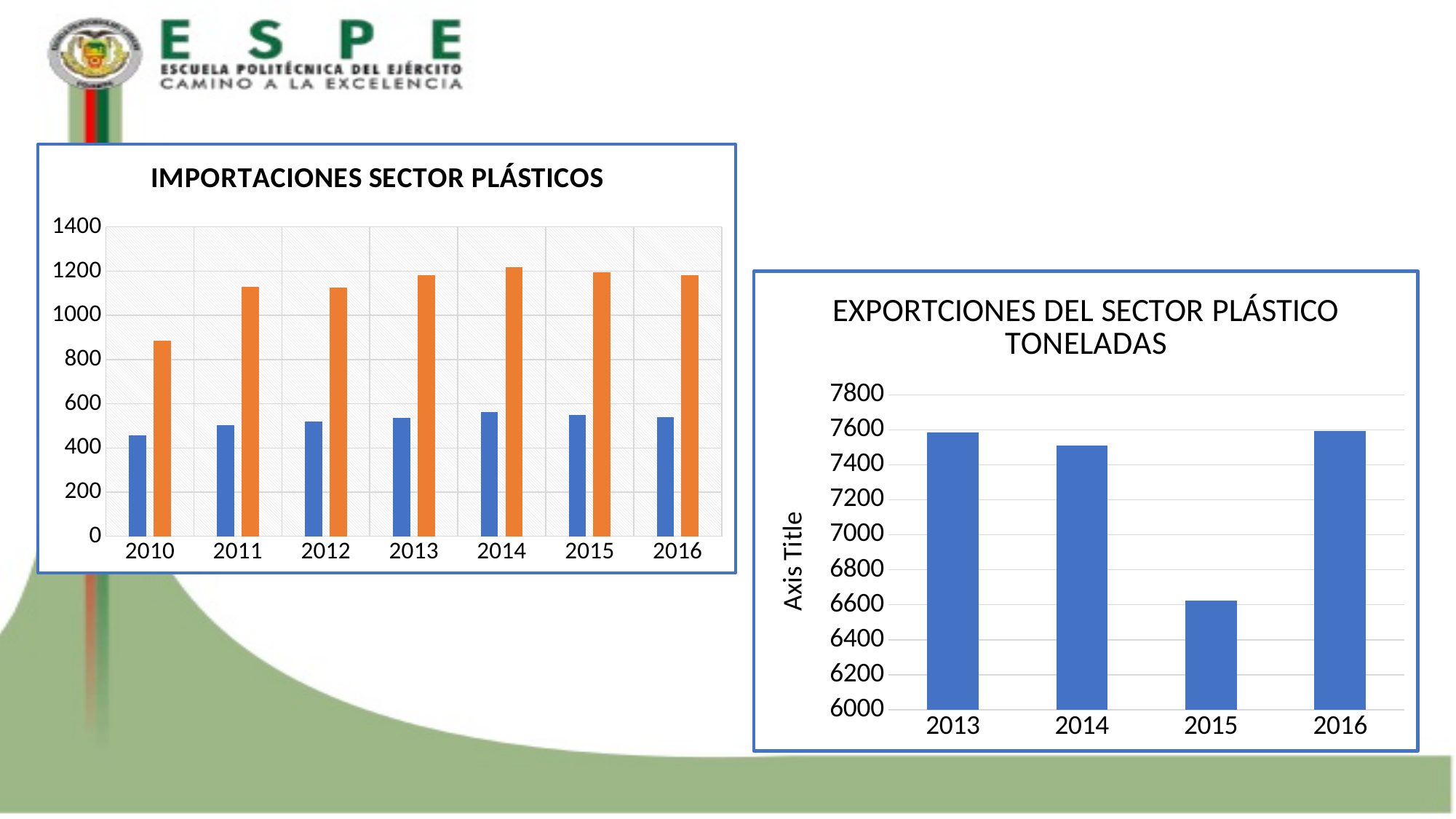
In the 'IMPORTACIONES SECTOR PLÁSTICOS' chart, which year has the lowest blue bar? 2010 In the 'IMPORTACIONES SECTOR PLÁSTICOS' chart, is the blue bar for 2014 greater or less than 600? less In the 'EXPORTCIONES DEL SECTOR PLÁSTICO TONELADAS' chart, which year has the lowest value? 2015 In the 'IMPORTACIONES SECTOR PLÁSTICOS' chart, which year has the lowest orange bar? 2010 What kind of chart is the 'IMPORTACIONES SECTOR PLÁSTICOS' chart? bar chart In the 'EXPORTCIONES DEL SECTOR PLÁSTICO TONELADAS' chart, is the value for 2015 greater or less than 7000? less In the 'IMPORTACIONES SECTOR PLÁSTICOS' chart, is the orange bar for 2010 greater or less than 1000? less In the 'EXPORTCIONES DEL SECTOR PLÁSTICO TONELADAS' chart, which is larger, the value for 2014 or the value for 2015? 2014 In the 'IMPORTACIONES SECTOR PLÁSTICOS' chart, which is larger for 2013, the blue bar or the orange bar? the orange bar How many bars are shown in the 'EXPORTCIONES DEL SECTOR PLÁSTICO TONELADAS' chart? 4 How many years are shown on the x axis of the 'IMPORTACIONES SECTOR PLÁSTICOS' chart? 7